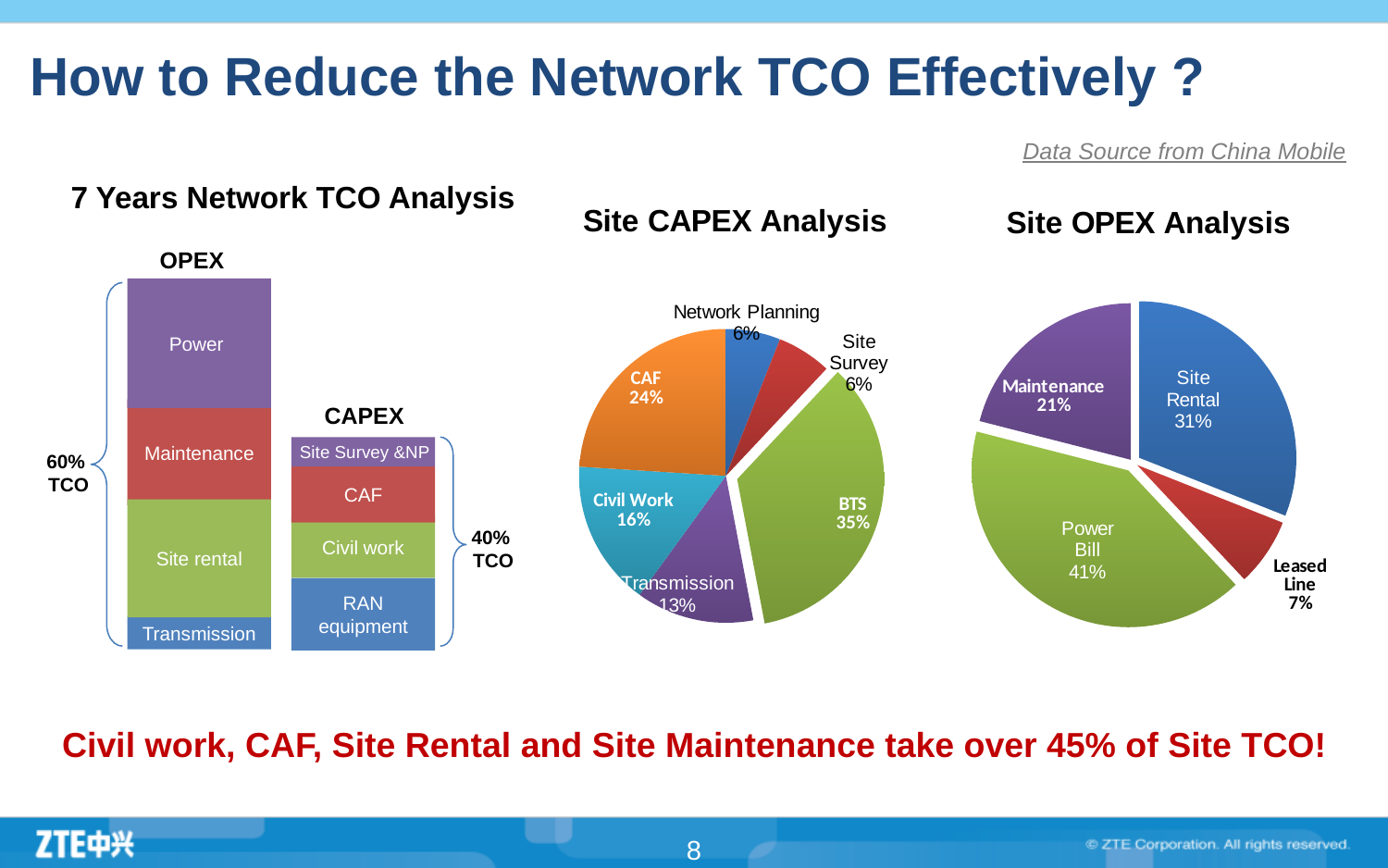
In the Site CAPEX Analysis chart, which category has the largest share? BTS In the Site OPEX Analysis chart, what is the difference between the Site Rental share and the Maintenance share? 10% How many slices does the Site OPEX Analysis pie chart have? 4 In the Site OPEX Analysis chart, what share does Power Bill take? 41% In the Site OPEX Analysis chart, what share does Leased Line take? 7% In the Site CAPEX Analysis chart, which is larger, Civil Work or Transmission? Civil Work In the Site CAPEX Analysis chart, what share does CAF take? 24% In the 7 Years Network TCO Analysis chart, what percentage of TCO does OPEX account for? 60% What type of chart is the Site CAPEX Analysis chart? Pie chart In the Site OPEX Analysis chart, which category has the smallest share? Leased Line In the Site CAPEX Analysis chart, what share does BTS take? 35% How many slices does the Site CAPEX Analysis pie chart have? 6